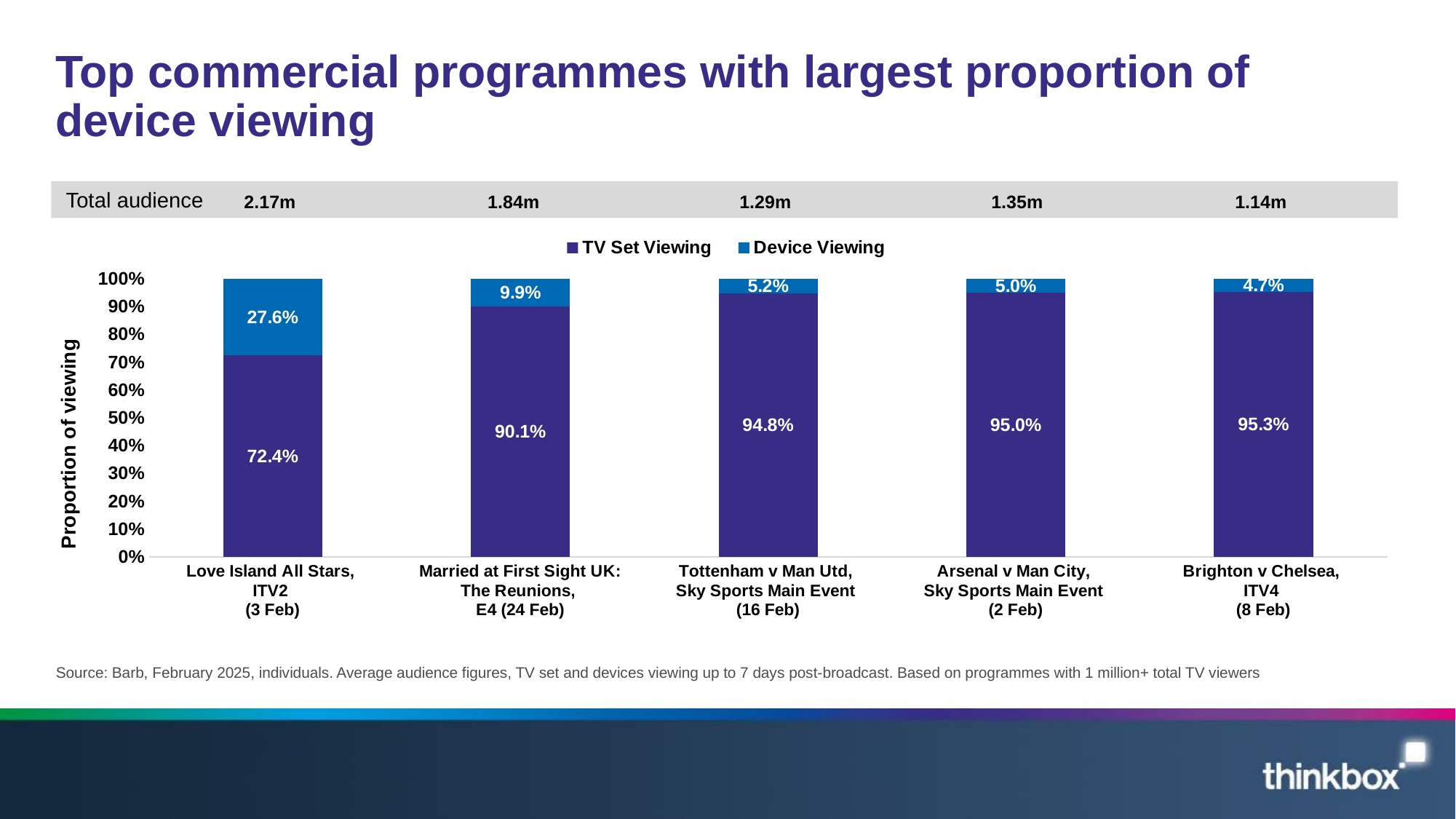
Which programme has the lowest Device Viewing share? Brighton v Chelsea, ITV4 (8 Feb) What is the TV Set Viewing share for Married at First Sight UK: The Reunions, E4 (24 Feb)? 90.1% Which has a larger TV Set Viewing share: Tottenham v Man Utd or Arsenal v Man City? Arsenal v Man City What is the total audience shown for Married at First Sight UK: The Reunions? 1.84m What is the Device Viewing share for Tottenham v Man Utd, Sky Sports Main Event (16 Feb)? 5.2% What kind of chart is shown on the slide? Stacked bar chart What is the Device Viewing share for Love Island All Stars, ITV2 (3 Feb)? 27.6% Which programme has the highest Device Viewing share? Love Island All Stars, ITV2 (3 Feb) What is the difference in Device Viewing share between Love Island All Stars and Married at First Sight UK: The Reunions? 17.7% What is the TV Set Viewing share for Brighton v Chelsea, ITV4 (8 Feb)? 95.3% How many series does the legend list? 2 How many programmes are shown on the chart? 5